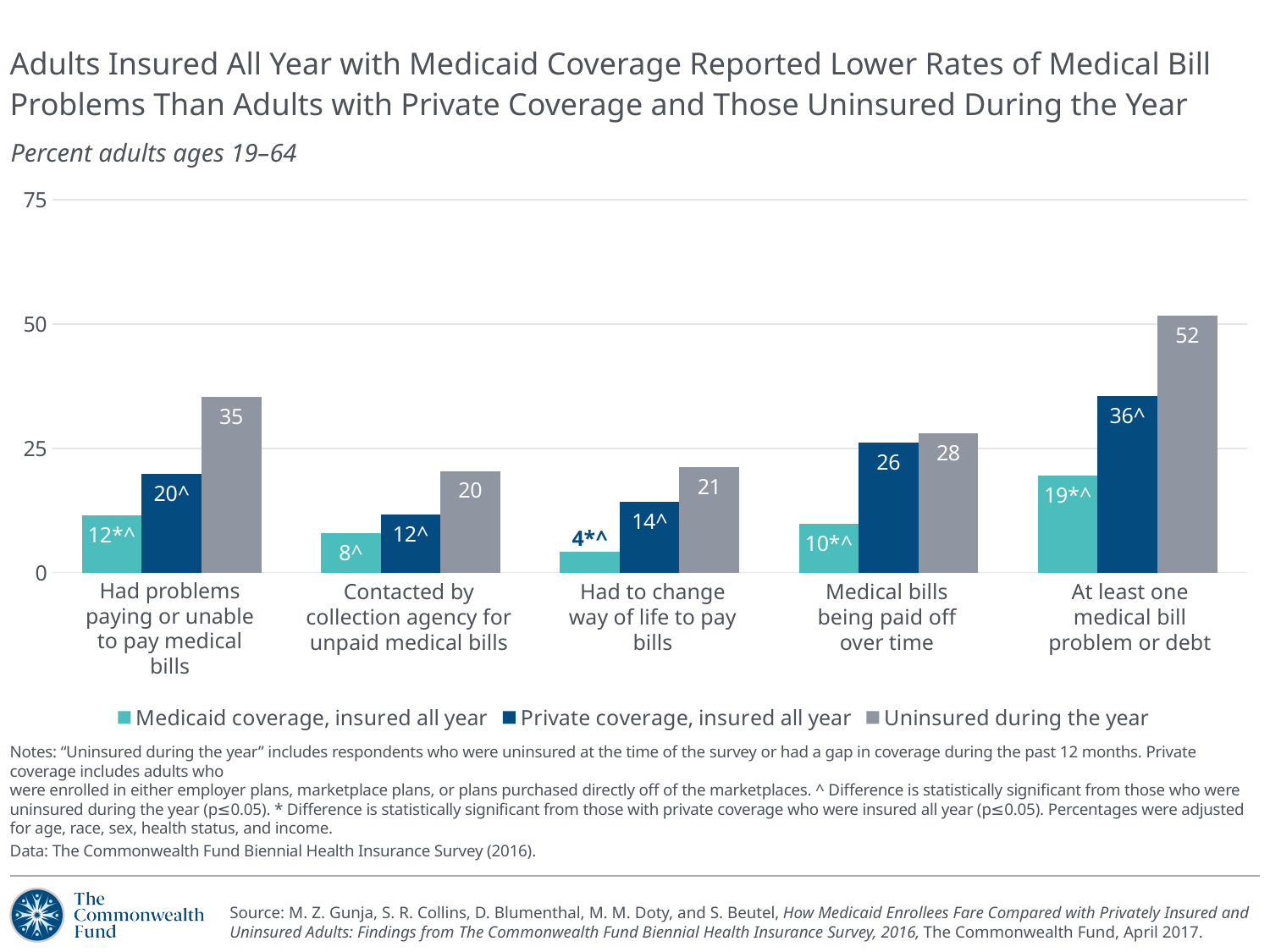
What is the subtitle shown below the chart title? Percent adults ages 19–64 How many categories are shown on the x axis? 5 Which category has the lowest value for Medicaid coverage, insured all year? Had to change way of life to pay bills What is the value for Private coverage, insured all year for 'Medical bills being paid off over time'? 26 What is the value for Medicaid coverage, insured all year for 'Had to change way of life to pay bills'? 4 What type of chart is shown on the slide? Bar chart For 'Contacted by collection agency for unpaid medical bills', which is larger: the Private coverage value or the Uninsured during the year value? Uninsured during the year Is the value for Private coverage, insured all year for 'At least one medical bill problem or debt' greater or less than 25? greater What is the difference between the Uninsured during the year value and the Medicaid coverage value for 'Had problems paying or unable to pay medical bills'? 23 Which category has the highest value for Uninsured during the year? At least one medical bill problem or debt What is the value for Uninsured during the year for 'At least one medical bill problem or debt'? 52 How many series does the legend list? 3